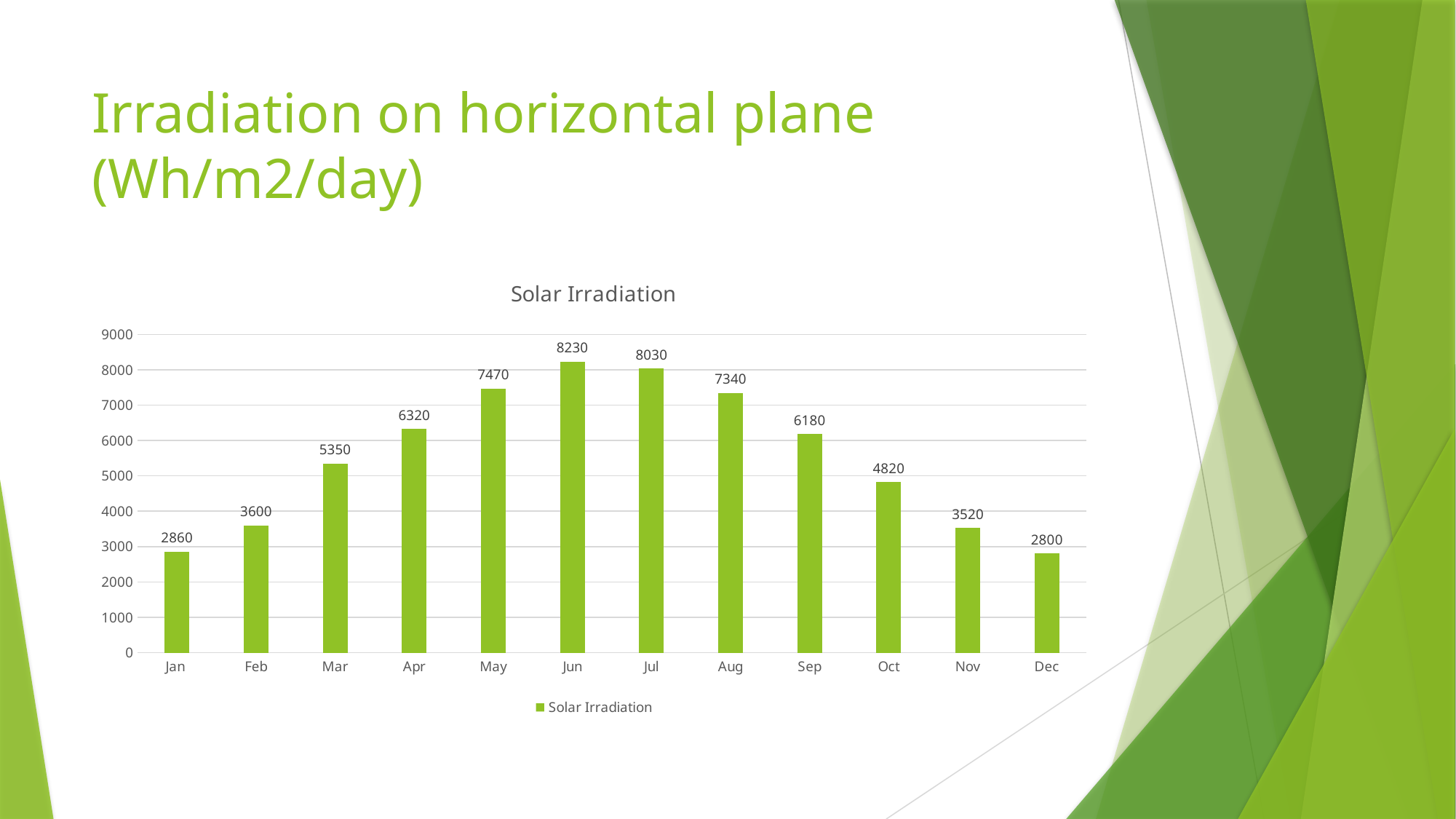
What is the solar irradiation value for Jun? 8230 Which month has the highest solar irradiation? Jun What is the solar irradiation value for Oct? 4820 What is the difference between the solar irradiation values for Jul and Jan? 5170 What kind of chart is shown on the slide? Bar chart What is the solar irradiation value for Mar? 5350 What is the title of the chart? Solar Irradiation How many months are shown on the x axis of the chart? 12 What is the difference between the solar irradiation values for Aug and Sep? 1160 Which has a higher solar irradiation value, Apr or Nov? Apr Is the value for May greater or less than 7000? greater Which month has the lowest solar irradiation? Dec